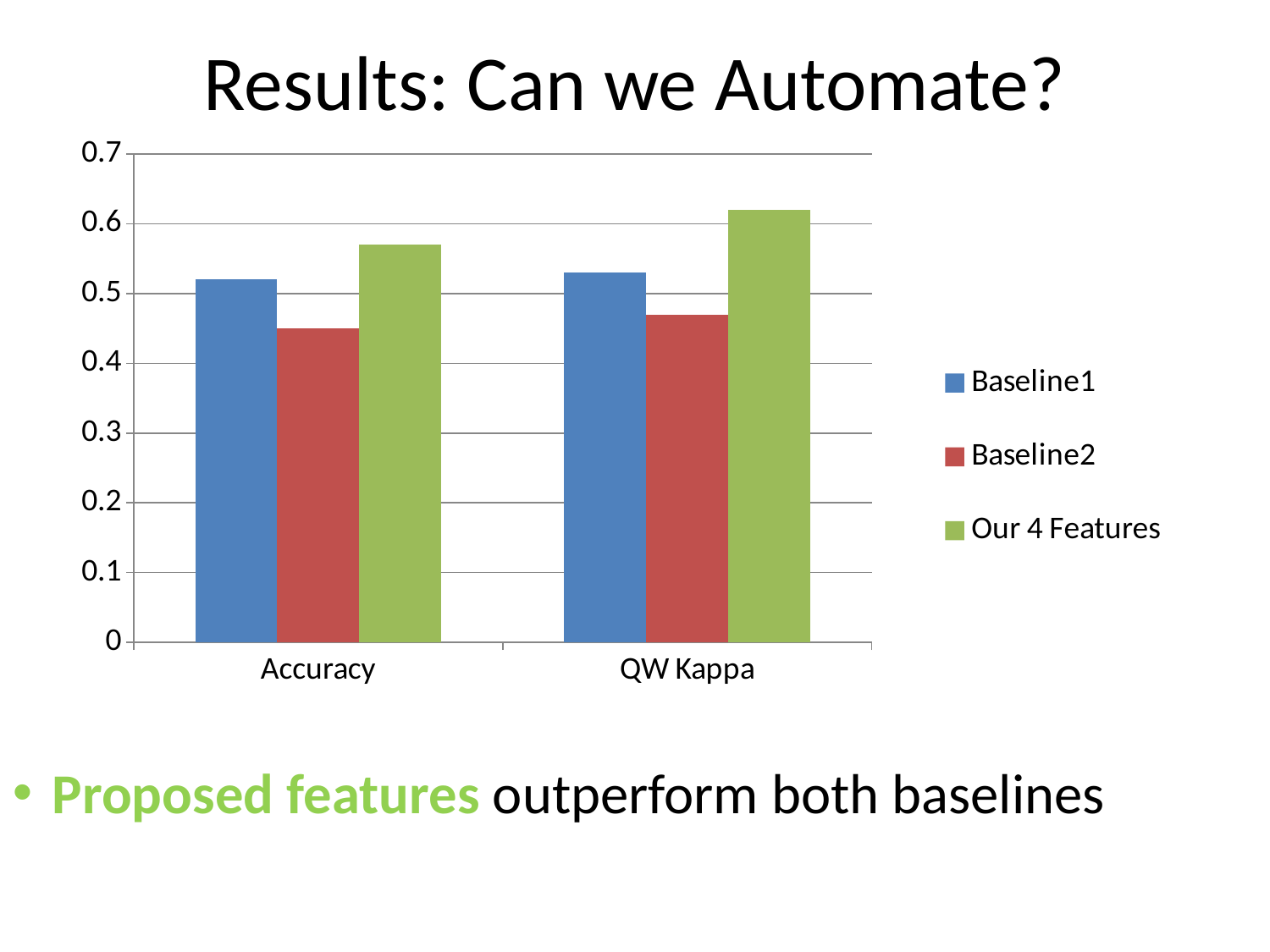
Which series has the highest value for QW Kappa? Our 4 Features What kind of chart is shown on the slide? bar chart Which series has the lowest value for Accuracy? Baseline2 Is the value for Baseline2 in QW Kappa greater or less than 0.5? less Is the value for Our 4 Features in Accuracy greater or less than 0.6? less How many categories are shown on the x axis? 2 Is the value for Our 4 Features in QW Kappa greater or less than 0.6? greater What colour are the bars for the Our 4 Features series? green How many series does the legend list? 3 For Accuracy, which is larger: Baseline1 or Our 4 Features? Our 4 Features For QW Kappa, which is larger: Baseline1 or Baseline2? Baseline1